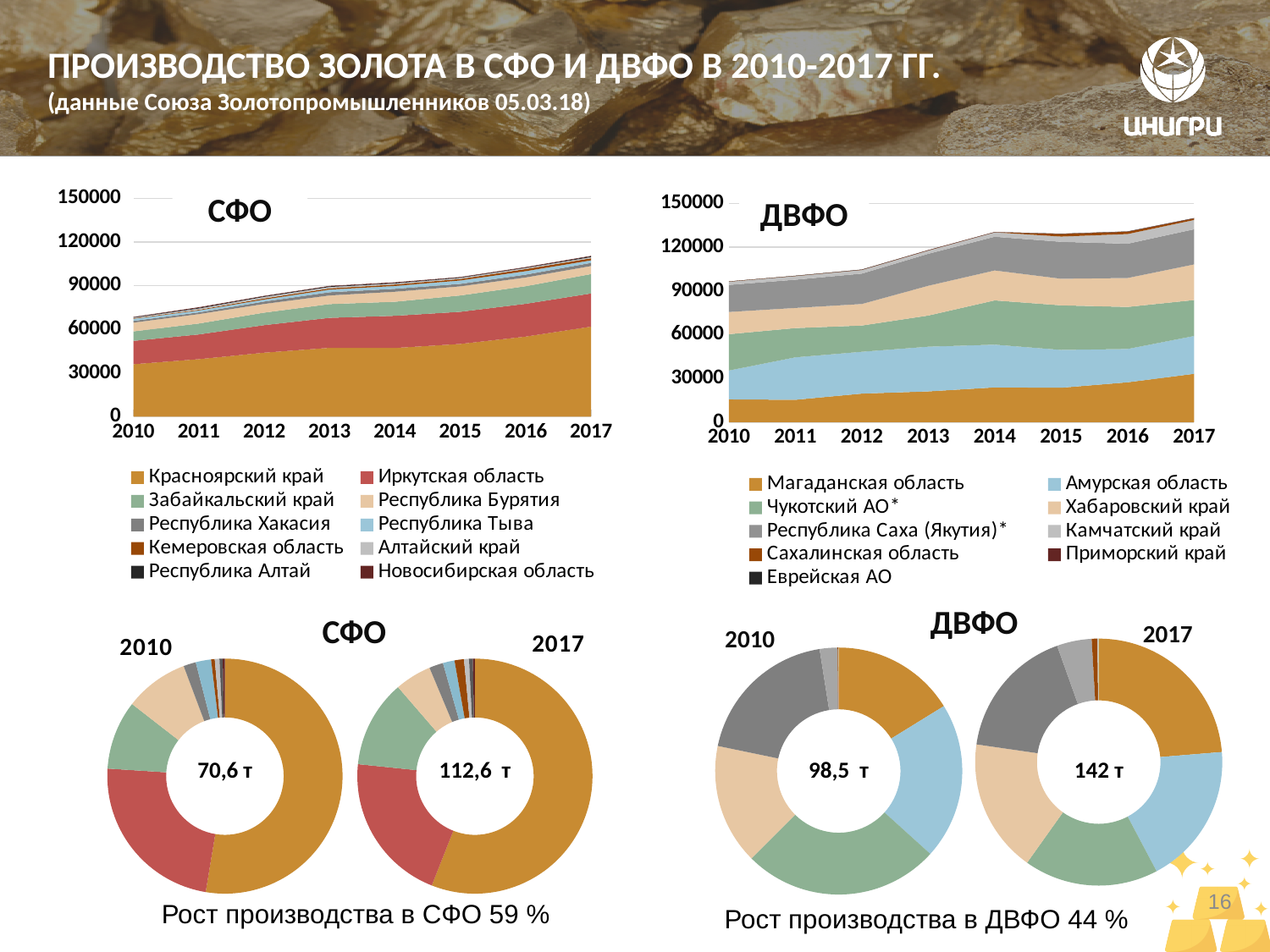
On the top-left area chart titled СФО, which series occupies the largest area? Красноярский край What total value is printed in the centre of the ДВФО 2010 donut chart? 98,5 т On the top-left area chart titled СФО, is the total stacked value in 2010 greater or less than 90000? less Which is larger: the centre value of the ДВФО 2017 donut chart or the СФО 2017 donut chart? ДВФО 2017 (142 т) On the top-right area chart titled ДВФО, is the total stacked value in 2017 greater or less than 120000? greater On the top-right area chart titled ДВФО, how many series does the legend list? 9 What is the difference between the centre values of the СФО 2017 and СФО 2010 donut charts? 42 т On the top-left area chart titled СФО, does the total stacked value rise or fall from 2010 to 2017? Rises What total value is printed in the centre of the СФО 2017 donut chart? 112,6 т On the top-left area chart titled СФО, how many series does the legend list? 10 On the top-left area chart titled СФО, how many years are shown on the x axis? 8 What kind of chart is the top-right chart titled ДВФО? Stacked area chart